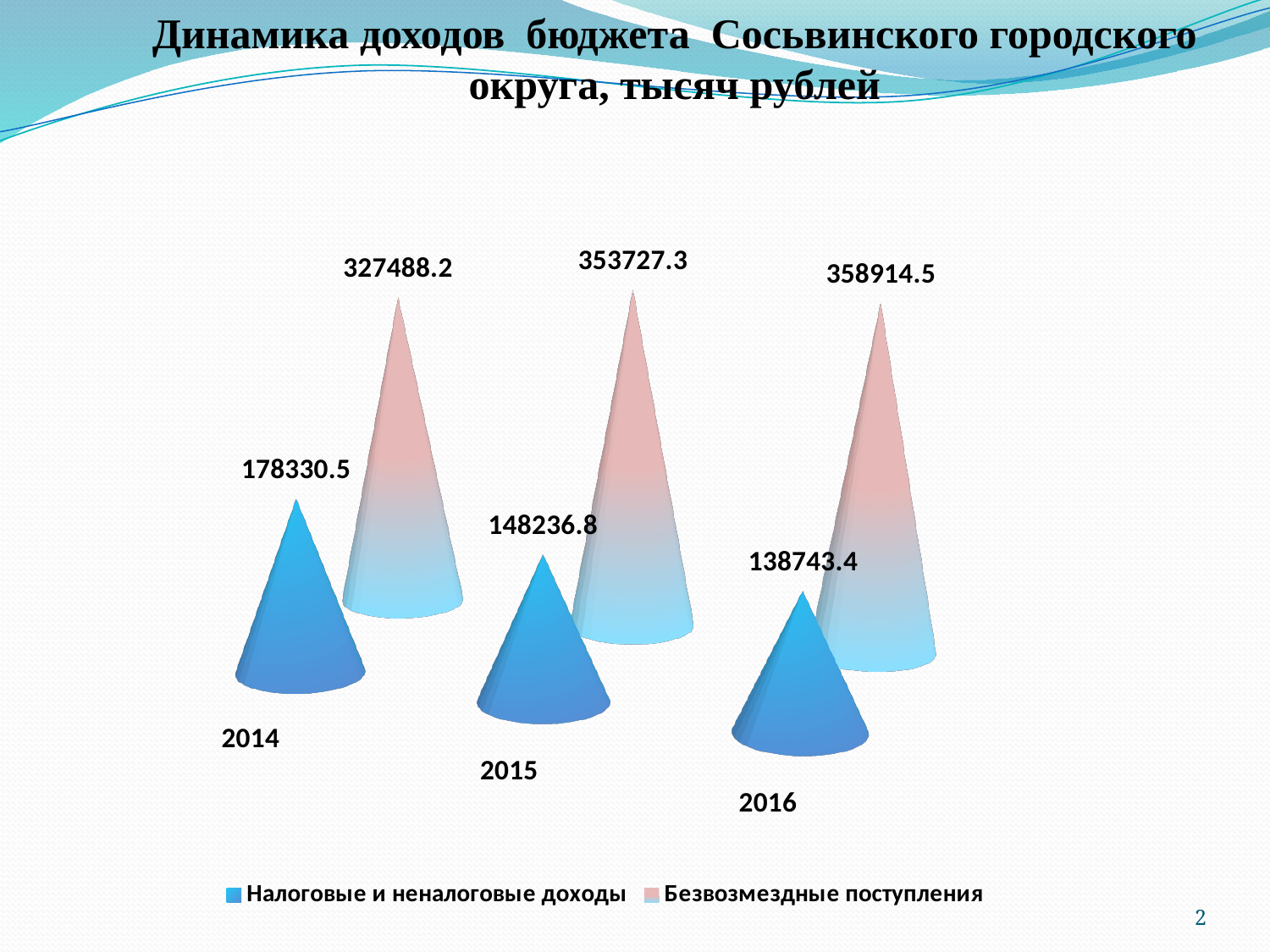
Do the values for Безвозмездные поступления rise or fall from 2014 to 2016? rise How many years are shown on the chart? 3 What is the difference between Безвозмездные поступления and Налоговые и неналоговые доходы in 2016? 220171.1 What is the value of Безвозмездные поступления for 2015? 353727.3 What is the value of Налоговые и неналоговые доходы for 2015? 148236.8 What is the value of Безвозмездные поступления for 2016? 358914.5 Which is larger in 2015: Налоговые и неналоговые доходы or Безвозмездные поступления? Безвозмездные поступления What is the value of Налоговые и неналоговые доходы for 2014? 178330.5 By how much did Налоговые и неналоговые доходы decrease from 2014 to 2016? 39587.1 In which year is Безвозмездные поступления lowest? 2014 In which year is Налоговые и неналоговые доходы highest? 2014 How many series does the legend list? 2